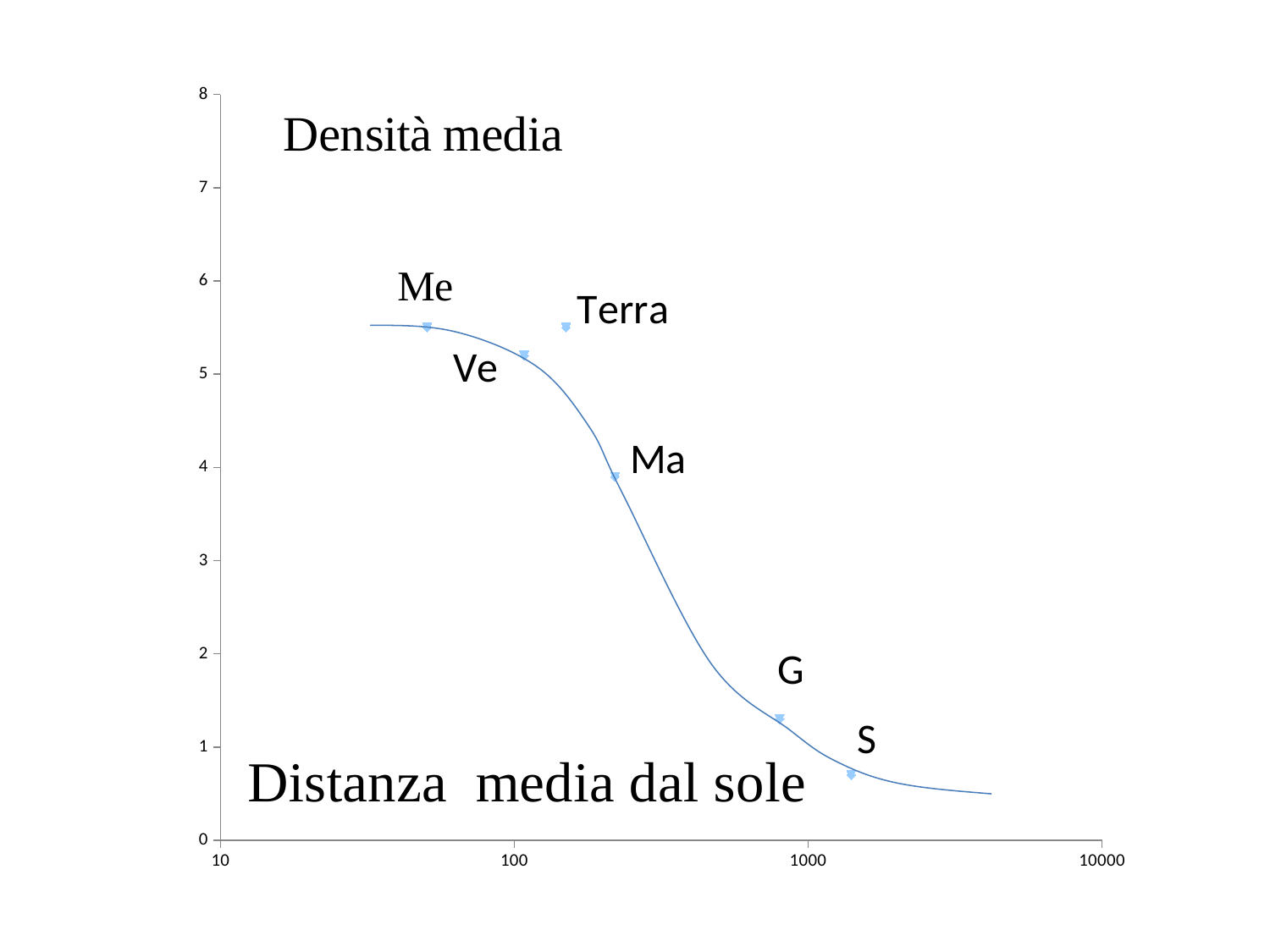
Which has the higher density value, Ve or Ma? Ve What kind of chart is shown on the slide? Scatter plot with a fitted curve Is the value for Terra greater or less than 5? greater What label is written for the vertical axis quantity on the chart? Densità media Which has the higher density value, Ma or G? Ma Do the values rise or fall as the distance from the sun increases along the x axis? fall Is the value for Ma greater or less than 5? less Is the value for Me greater or less than 5? greater How many labelled data points are plotted on the chart? 6 Which labelled point has the lowest density value? S